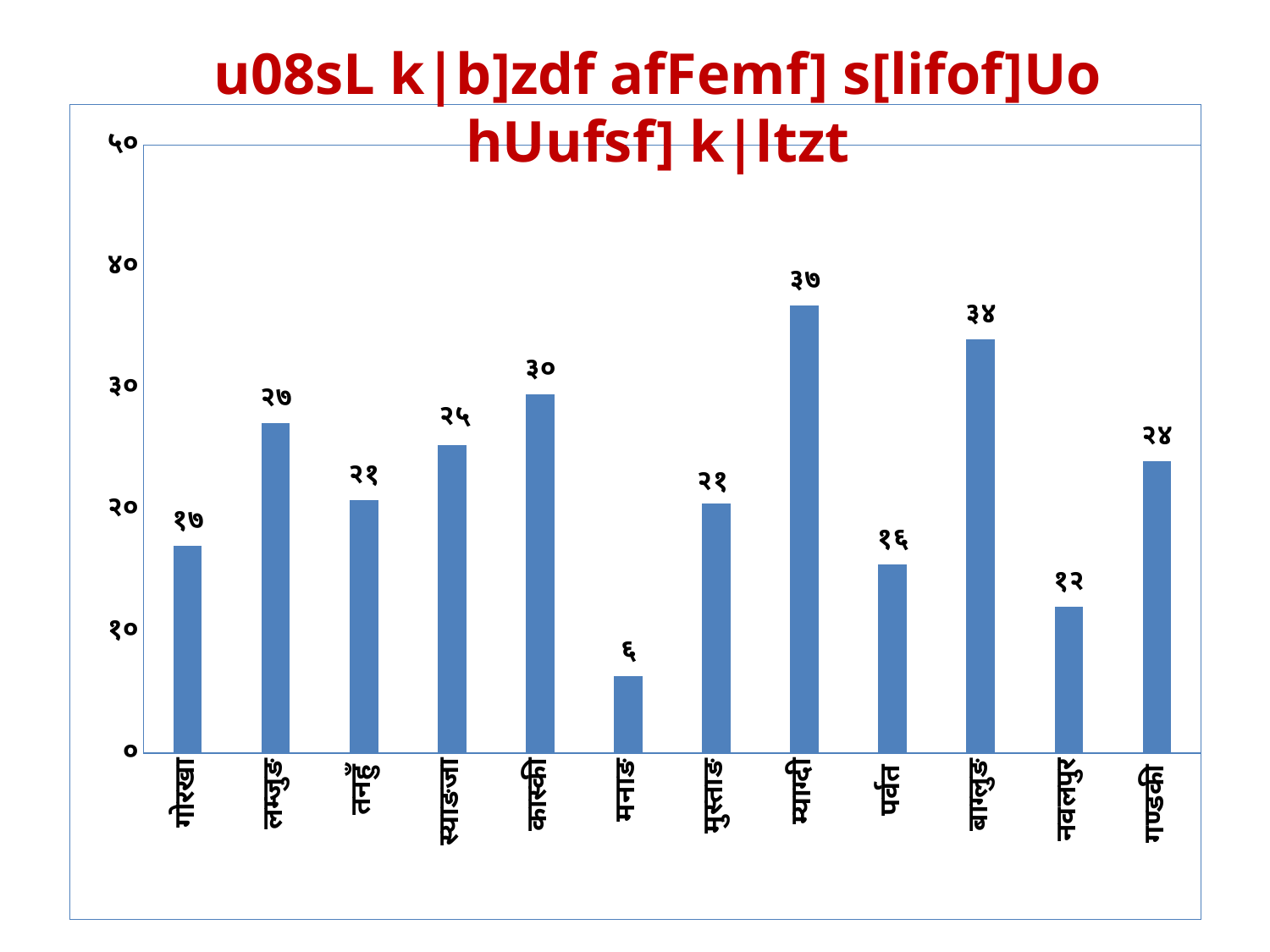
Which category has the lowest value? मनाङ What kind of chart is shown on the slide? bar chart Which category has the highest value? म्याग्दी Is the value for स्याङ्जा greater or less than ३०? less Which is larger, the value for कास्की or the value for लम्जुङ? कास्की What is the value for गोरखा? १७ What is the value for गण्डकी? २४ What colour are the bars in the chart? blue What is the value for म्याग्दी? ३७ What is the value for नवलपुर? १२ How many categories are shown on the x axis? 12 What is the difference between the values for बाग्लुङ and पर्वत? १८